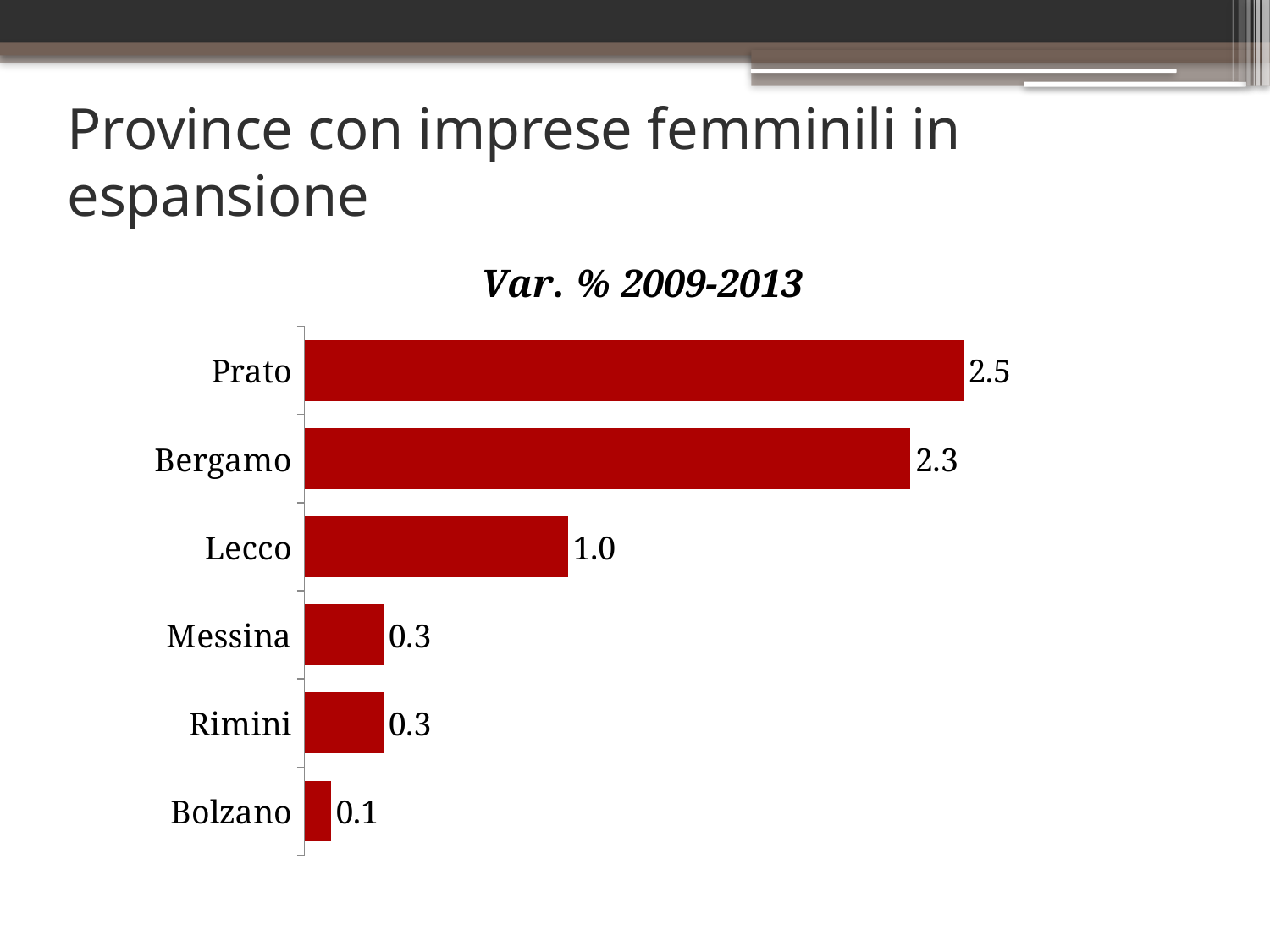
Which is larger, the value for Lecco or the value for Messina? Lecco What is the value for Bolzano? 0.1 What is the value for Bergamo? 2.3 How many provinces are shown in the chart? 6 Which province has the highest value? Prato What kind of chart is shown on the slide? Bar chart What is the title of the chart? Var. % 2009-2013 What is the difference between the values for Prato and Lecco? 1.5 What is the difference between the values for Bergamo and Bolzano? 2.2 What is the value for Prato? 2.5 Which province has the lowest value? Bolzano What is the value for Lecco? 1.0